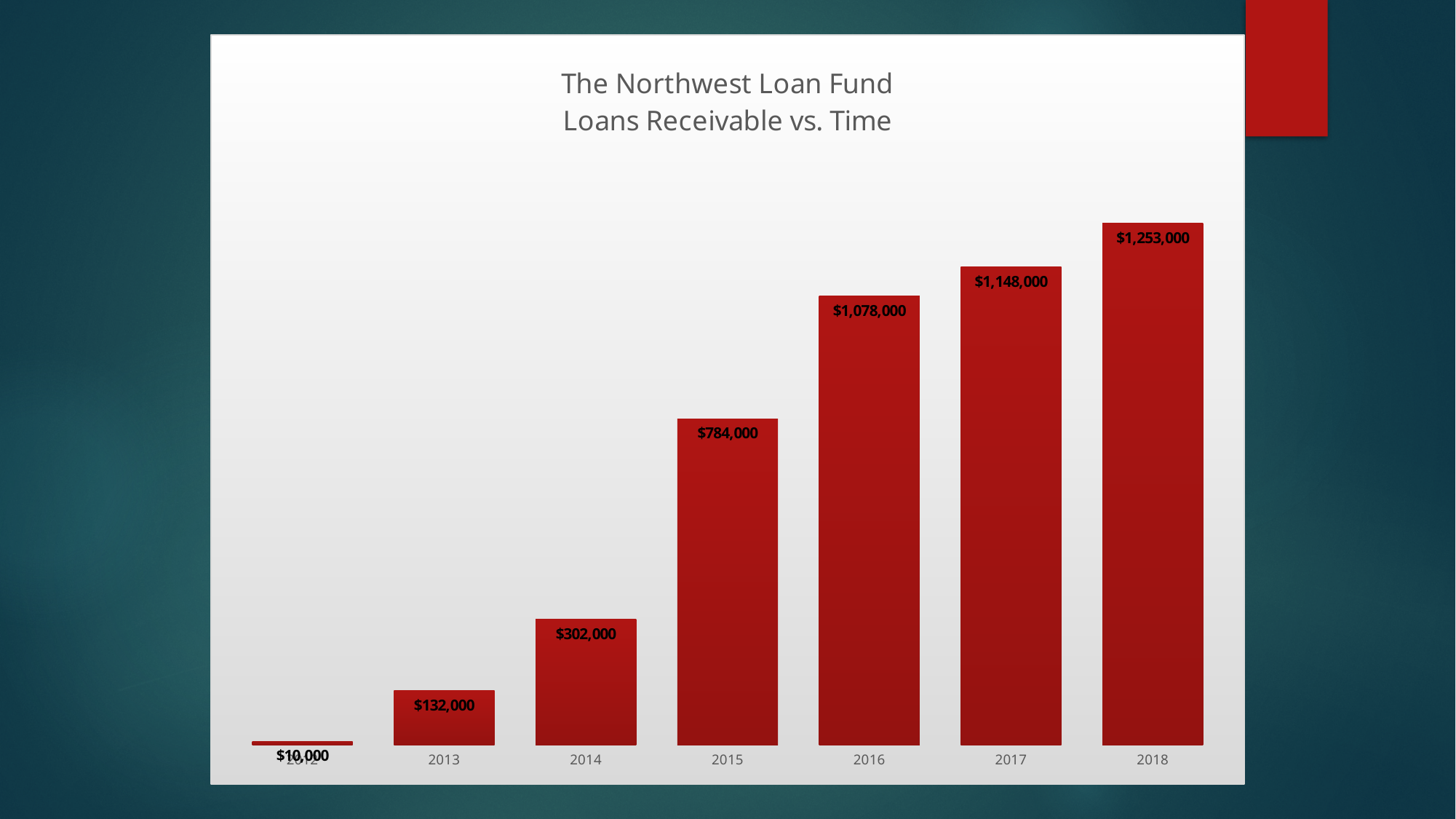
What is the difference between loans receivable in 2015 and 2014? $482,000 How many years are shown on the chart? 7 Which year has larger loans receivable, 2014 or 2016? 2016 Do loans receivable rise or fall from 2012 to 2018? Rise What is the value of loans receivable in 2017? $1,148,000 What is the value of loans receivable in 2015? $784,000 Which year has the lowest loans receivable? 2012 What kind of chart is shown on the slide? Bar chart What is the value of loans receivable in 2013? $132,000 What is the difference between loans receivable in 2018 and 2017? $105,000 What is the title of the chart? The Northwest Loan Fund Loans Receivable vs. Time Which year has the highest loans receivable? 2018